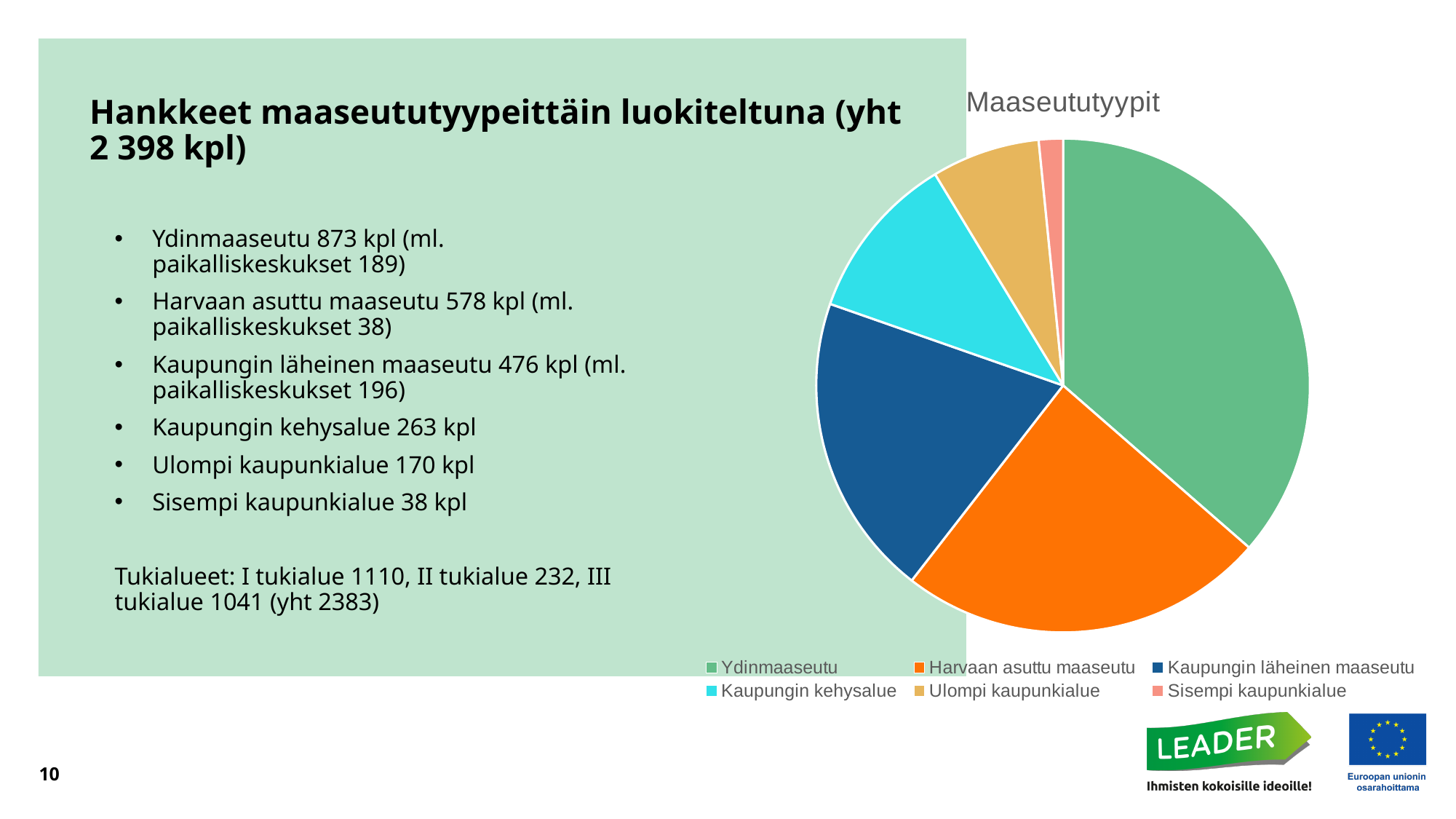
What colour is the Ydinmaaseutu slice in the pie chart? green What is the difference in projects between Harvaan asuttu maaseutu (578 kpl) and Kaupungin läheinen maaseutu (476 kpl)? 102 kpl How many slices does the pie chart have? 6 What is the title of the pie chart? Maaseututyypit Which slice is larger: Ulompi kaupunkialue or Kaupungin läheinen maaseutu? Kaupungin läheinen maaseutu Which category has the largest slice in the pie chart? Ydinmaaseutu What kind of chart is shown on the slide? pie chart Which category has the smallest slice in the pie chart? Sisempi kaupunkialue According to the slide, how many projects (kpl) are in the Ydinmaaseutu category? 873 kpl According to the slide, how many projects (kpl) are in the Kaupungin kehysalue category? 263 kpl Which slice is larger: Harvaan asuttu maaseutu or Kaupungin kehysalue? Harvaan asuttu maaseutu How many categories does the pie chart's legend list? 6